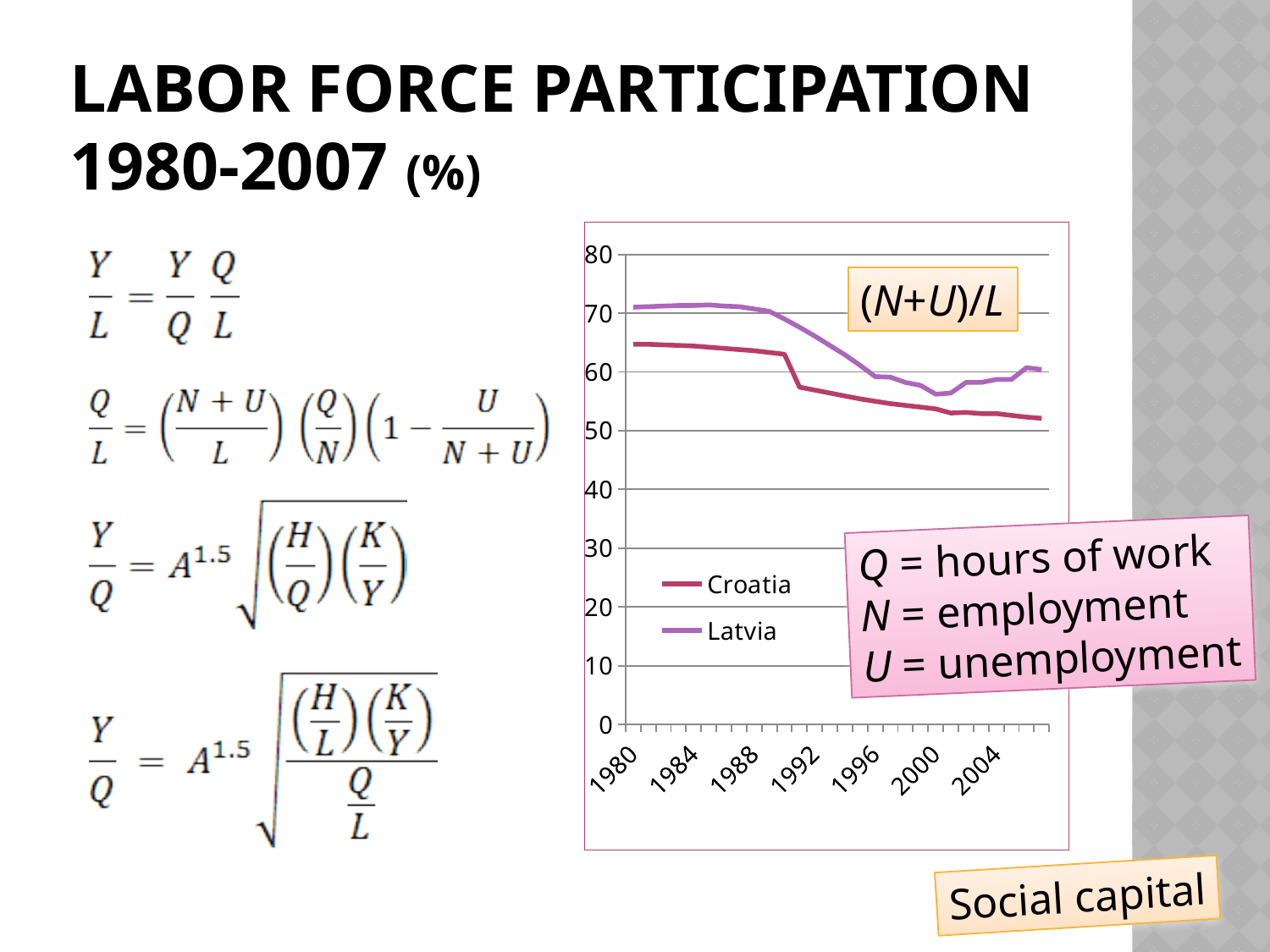
Is the value for Croatia in 1980 greater or less than 60? greater Which two countries are plotted in the chart? Croatia and Latvia What kind of chart is shown on the slide? line chart How many year labels are shown on the x axis of the chart? 7 Is the value for Croatia in 2004 greater or less than 60? less Which country has the higher labor force participation in 2004, Croatia or Latvia? Latvia Is the value for Latvia in 1996 greater or less than 70? less What colour is the Latvia line in the chart? purple How many series does the chart's legend list? 2 Does the Croatia line rise or fall from 1980 to 2007? fall Which country has the higher labor force participation in 1980, Croatia or Latvia? Latvia